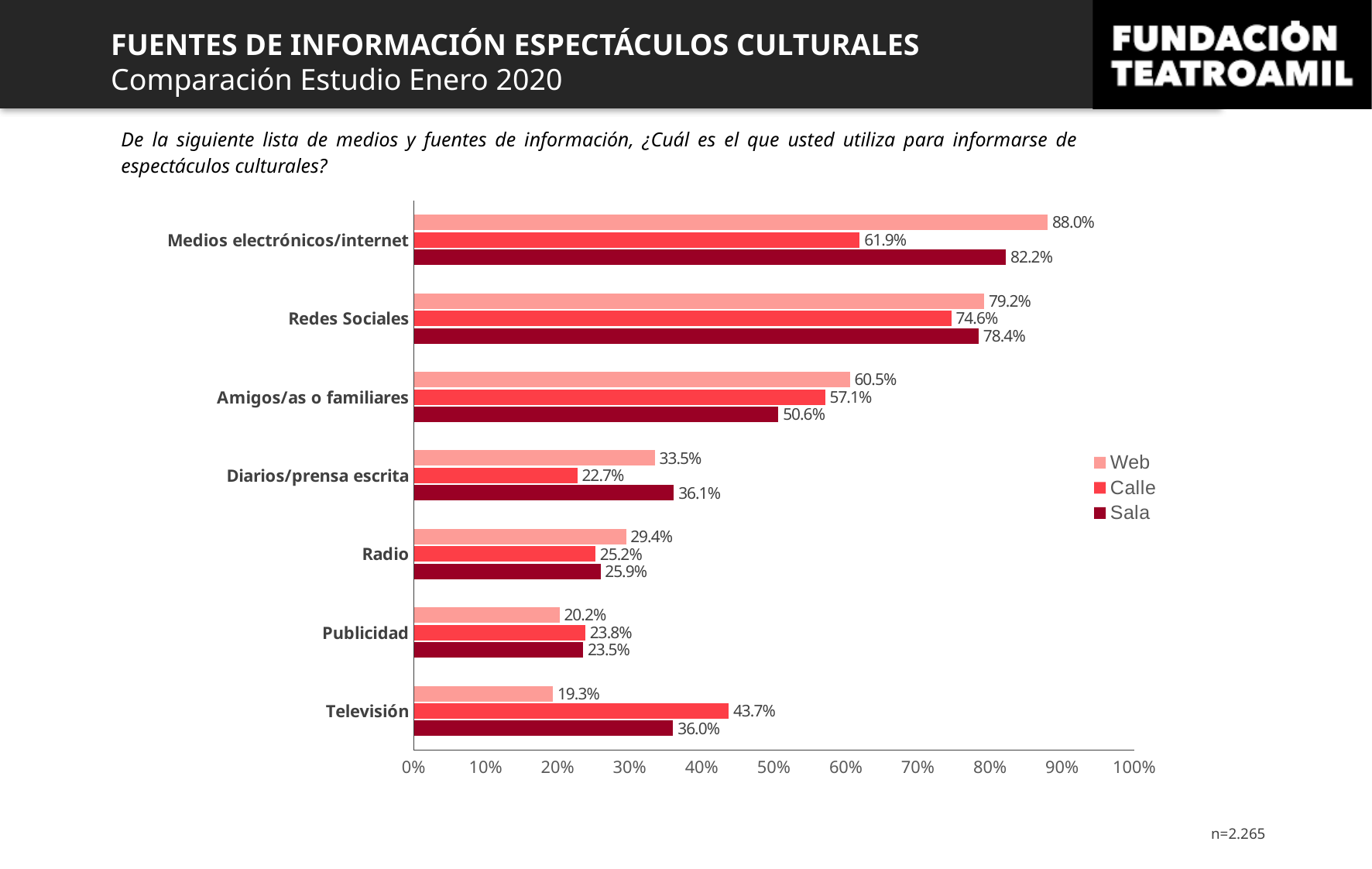
What kind of chart is shown on the slide? Bar chart How many categories are shown on the chart? 7 Which is larger for Televisión, the Calle value or the Web value? Calle Which category has the lowest Web value? Televisión What is the Calle value for Televisión? 43.7% What are the three series listed in the legend? Web, Calle, Sala What is the difference between the Web and Calle values for Medios electrónicos/internet? 26.1% Which category has the highest Web value? Medios electrónicos/internet Is the Sala value for Amigos/as o familiares greater or less than 40%? greater How many series does the legend list? 3 What is the Web value for Medios electrónicos/internet? 88.0% What is the Sala value for Diarios/prensa escrita? 36.1%